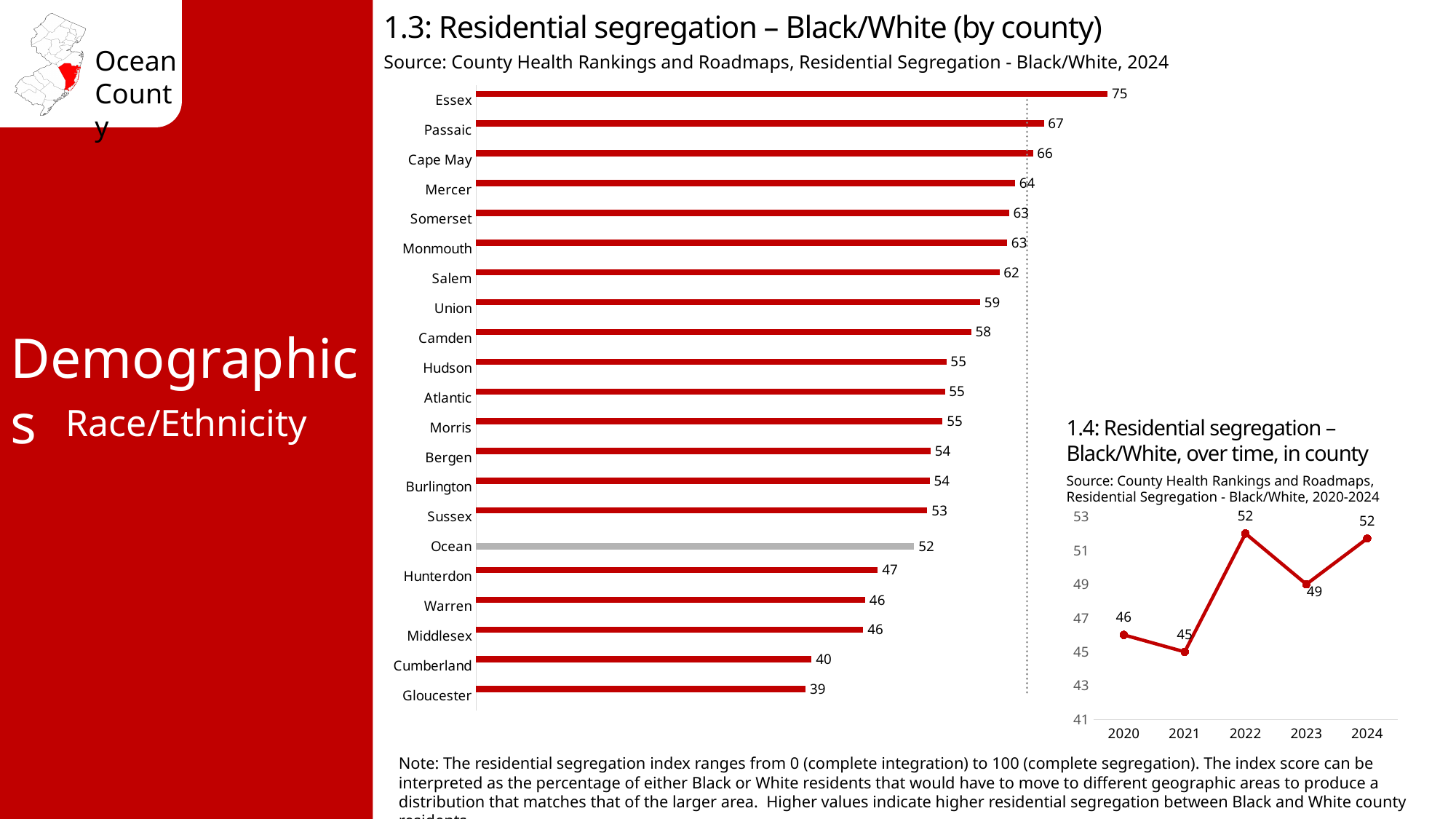
In the chart '1.3: Residential segregation – Black/White (by county)', what is the difference between the values for Essex and Gloucester? 36 In the chart '1.3: Residential segregation – Black/White (by county)', what is the value for Ocean? 52 What kind of chart is '1.4: Residential segregation – Black/White, over time, in county'? Line chart In the chart '1.3: Residential segregation – Black/White (by county)', which has a larger value, Passaic or Hunterdon? Passaic In the chart '1.3: Residential segregation – Black/White (by county)', which county has the lowest value? Gloucester In the chart '1.3: Residential segregation – Black/White (by county)', what is the value for Cumberland? 40 What kind of chart is '1.3: Residential segregation – Black/White (by county)'? Bar chart In the chart '1.4: Residential segregation – Black/White, over time, in county', which year has the lowest value? 2021 In the chart '1.4: Residential segregation – Black/White, over time, in county', what is the value for 2021? 45 In the chart '1.3: Residential segregation – Black/White (by county)', which county has the highest value? Essex In the chart '1.4: Residential segregation – Black/White, over time, in county', what is the difference between the values for 2022 and 2023? 3 How many counties are shown in the chart '1.3: Residential segregation – Black/White (by county)'? 21